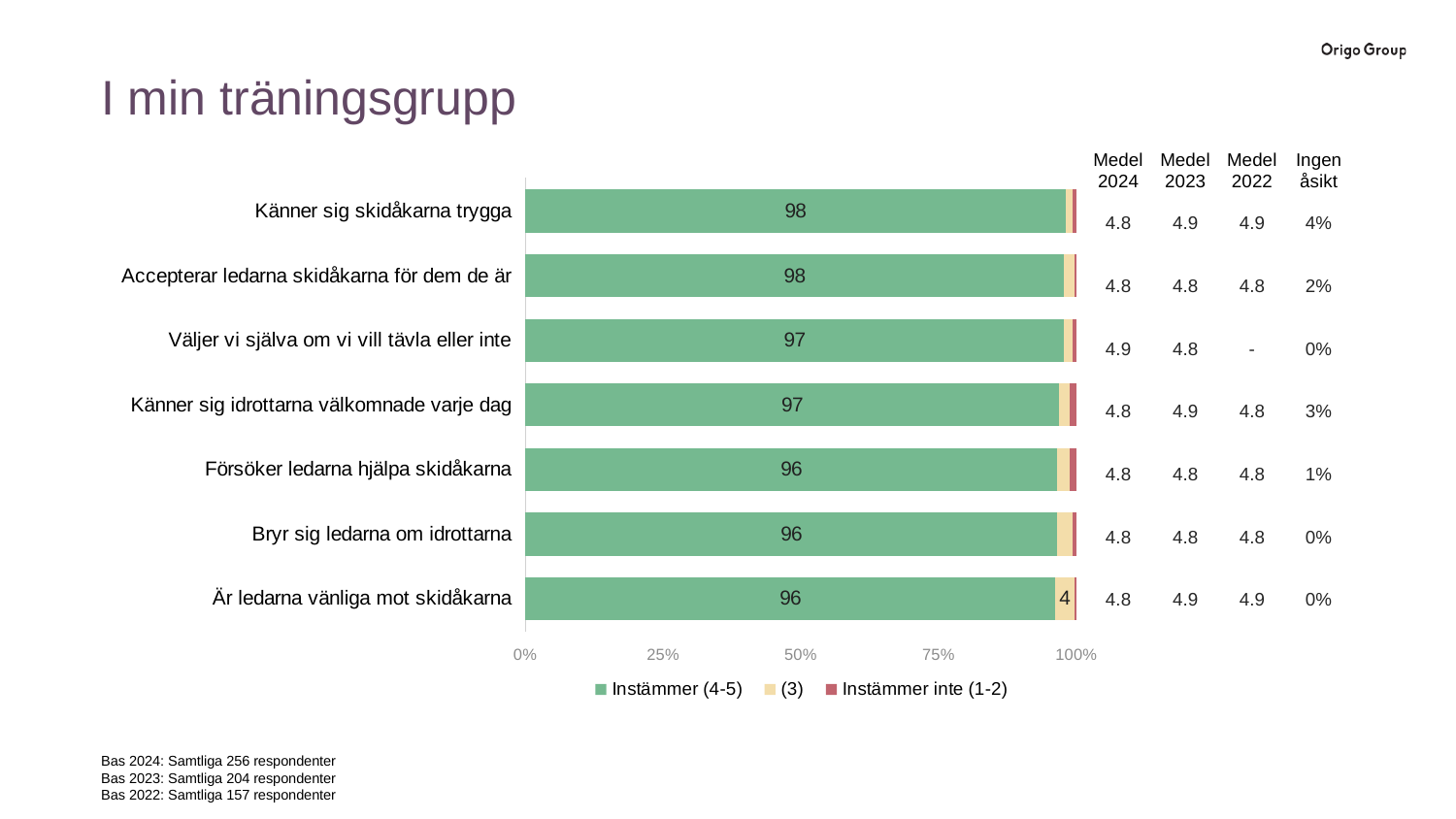
What is the value of the "(3)" series for "Är ledarna vänliga mot skidåkarna"? 4 What is the "Instämmer (4-5)" value for "Väljer vi själva om vi vill tävla eller inte"? 97 How many series does the legend list? 3 What is the value of the "Instämmer (4-5)" series for "Känner sig skidåkarna trygga"? 98 How many categories (statements) are shown in the chart? 7 What is the "Ingen åsikt" value for "Känner sig skidåkarna trygga"? 4% What is the title of the slide? I min träningsgrupp What kind of chart is shown on the slide? Stacked bar chart Which is larger for the "Instämmer (4-5)" series: "Känner sig skidåkarna trygga" or "Försöker ledarna hjälpa skidåkarna"? Känner sig skidåkarna trygga Is the "Instämmer (4-5)" value for "Bryr sig ledarna om idrottarna" greater or less than 75%? greater What is the "Medel 2024" value for "Väljer vi själva om vi vill tävla eller inte"? 4.9 What is the difference between the "Instämmer (4-5)" values for "Accepterar ledarna skidåkarna för dem de är" and "Bryr sig ledarna om idrottarna"? 2